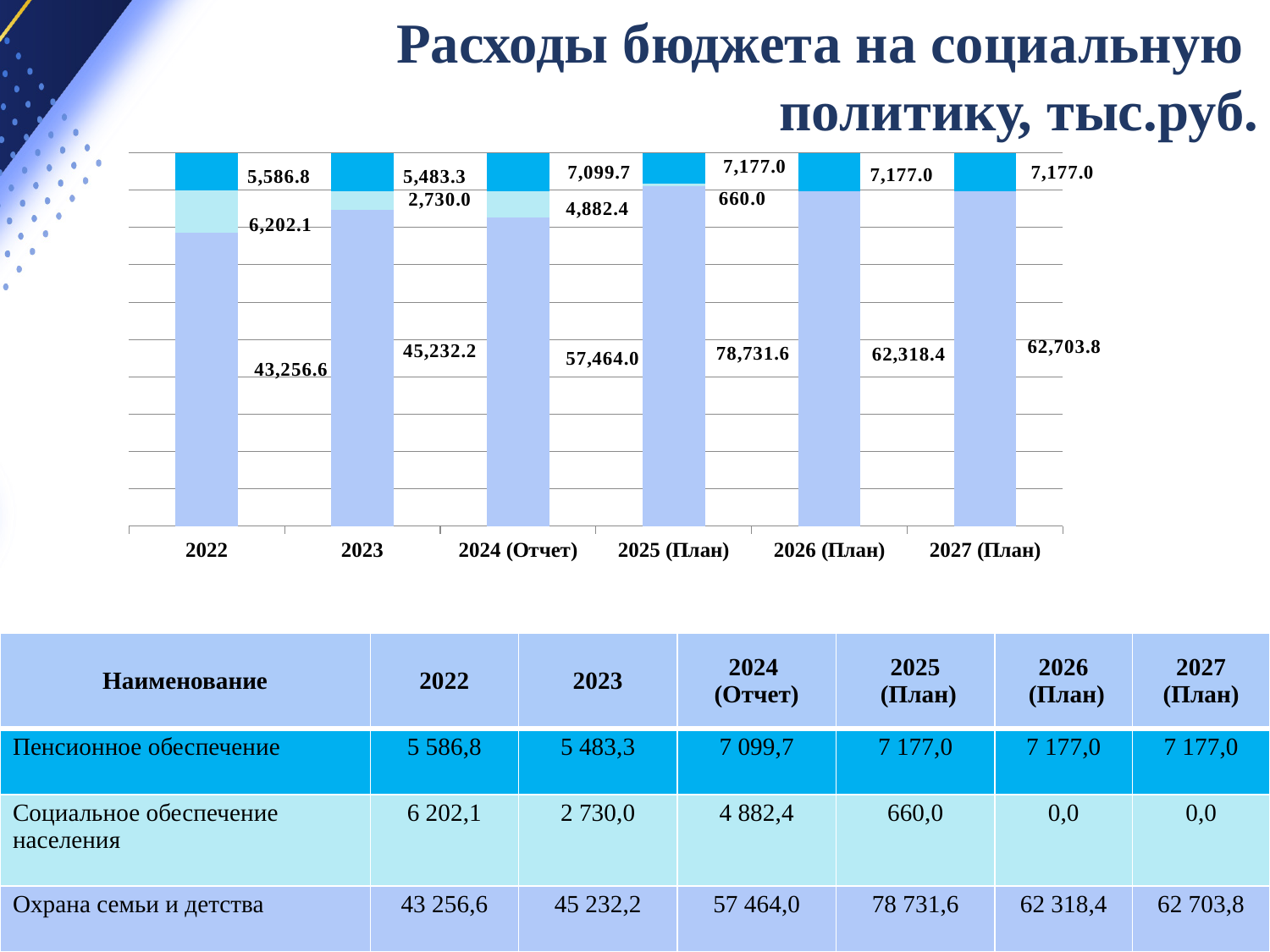
What is the value of the top segment of the bar for 2024 (Отчет)? 7,099.7 What is the value of the middle segment of the bar for 2022? 6,202.1 Which is larger, the bottom segment for 2026 (План) or for 2027 (План)? 2027 (План) What is the total of the stacked bar for 2022? 55,045.5 What kind of chart is shown on the slide? Stacked bar chart What is the value of the largest (bottom) segment of the bar for 2025 (План)? 78,731.6 What is the title of the chart on the slide? Расходы бюджета на социальную политику, тыс.руб. What is the difference between the bottom segment values for 2025 (План) and 2024 (Отчет)? 21,267.6 How many categories (years) are shown on the x axis of the chart? 6 Does the bottom segment (Охрана семьи и детства) rise or fall from 2022 to 2025 (План)? Rise In which year is the bottom segment (Охрана семьи и детства) the lowest? 2022 In which year is the bottom segment (Охрана семьи и детства) the highest? 2025 (План)